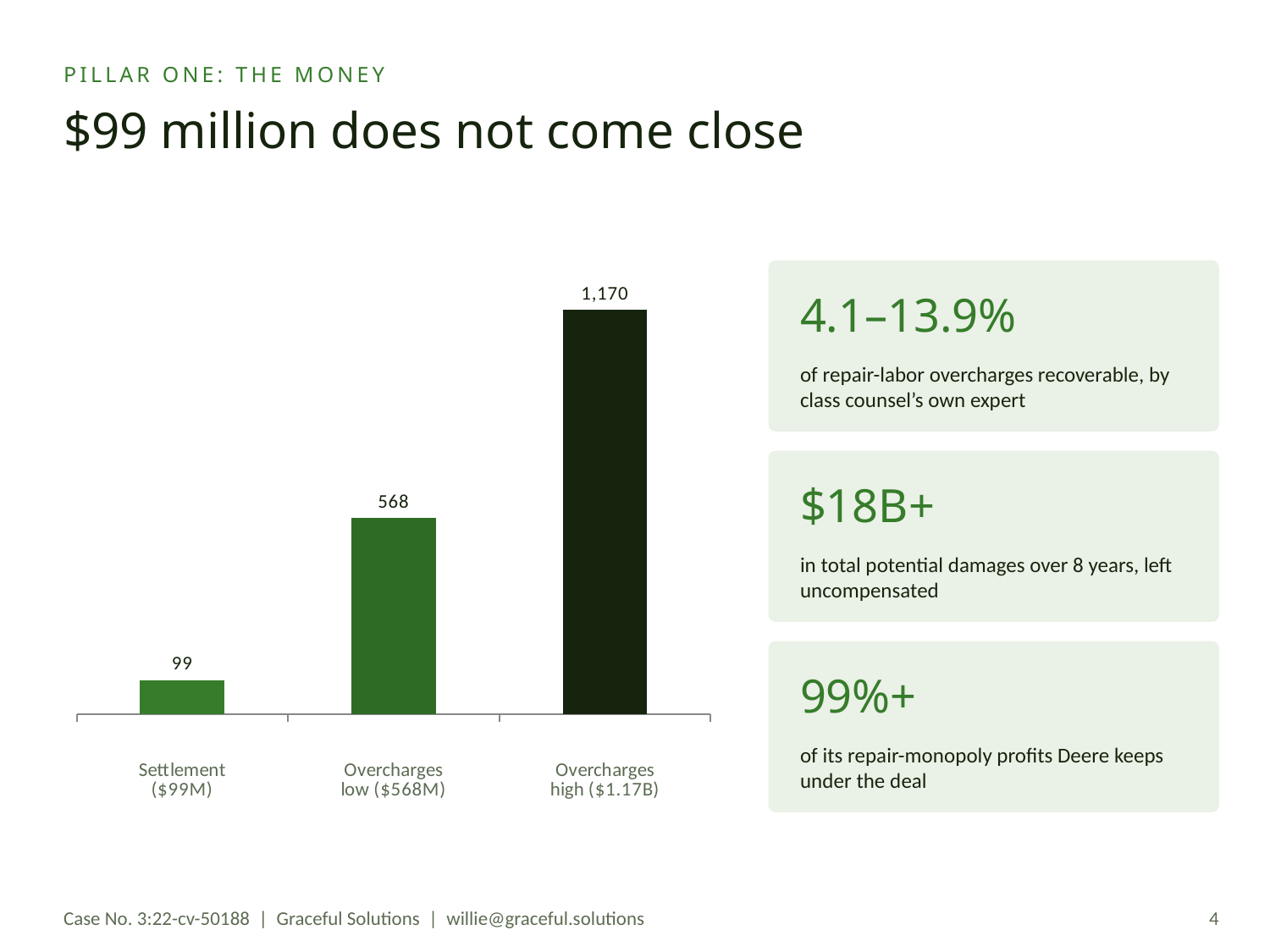
What is the difference between the Overcharges low and Settlement values? 469 What is the value of the Settlement ($99M) bar? 99 Do the values rise or fall from left to right across the categories? Rise Which is larger, the Settlement bar or the Overcharges low bar? Overcharges low Which category has the highest value? Overcharges high ($1.17B) What is the difference between the Overcharges high and Overcharges low values? 602 What colour is the Overcharges high ($1.17B) bar? Dark green (near black) What is the value of the Overcharges high ($1.17B) bar? 1,170 How many categories are shown in the chart? 3 What is the value of the Overcharges low ($568M) bar? 568 Which category has the lowest value? Settlement ($99M) What kind of chart is shown on the slide? Bar chart